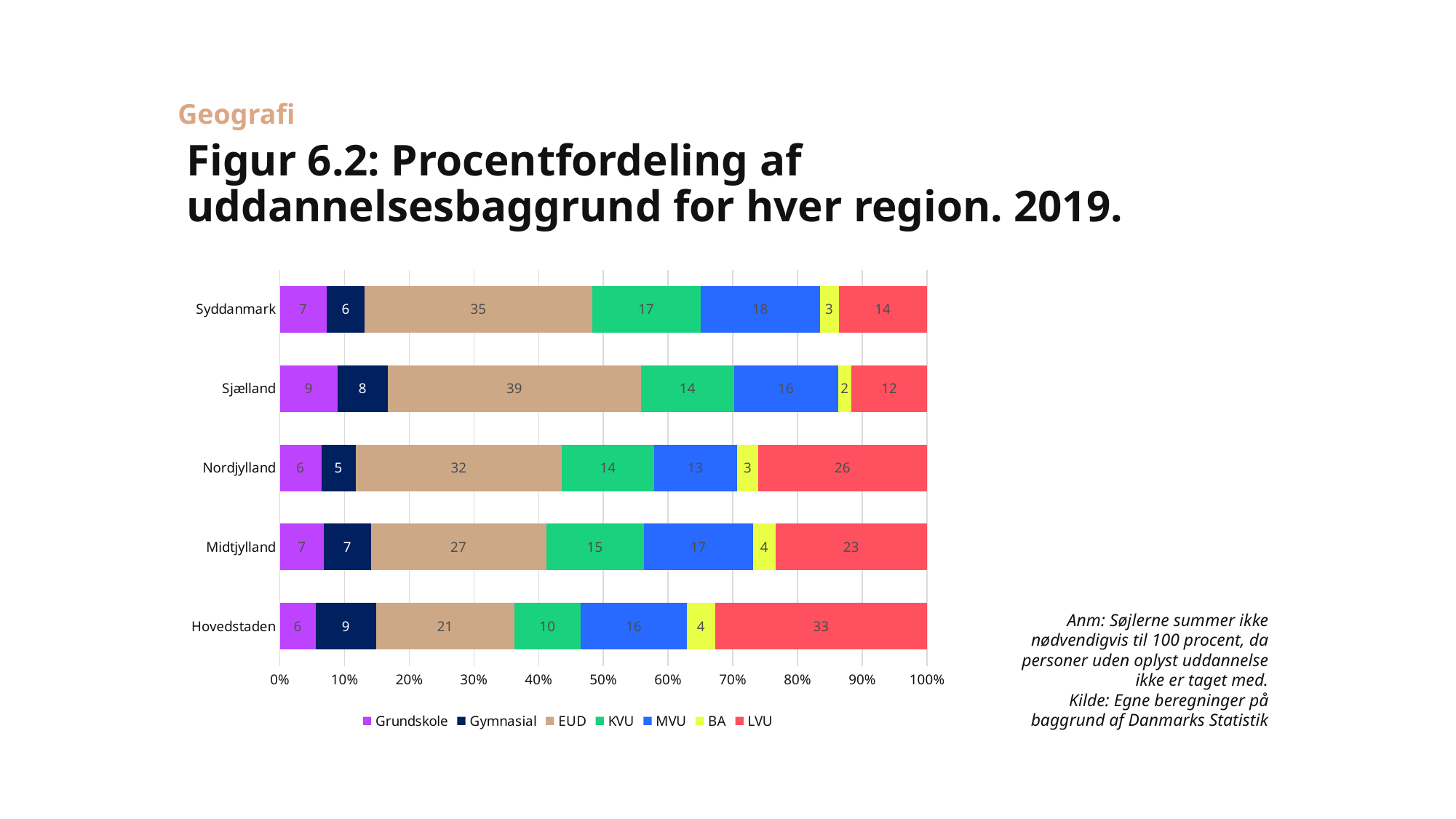
Which region has the lowest EUD value? Hovedstaden What is the Gymnasial value for Hovedstaden? 9 Which colour represents the BA series in the legend? Yellow How many series does the legend list? 7 Which is larger, the KVU value for Syddanmark or the KVU value for Hovedstaden? Syddanmark What kind of chart is shown on the slide? Stacked bar chart Which region has the highest LVU value? Hovedstaden What is the difference between the LVU values for Nordjylland and Syddanmark? 12 What is the EUD value for Sjælland? 39 How many regions are shown on the chart? 5 What is the LVU value for Hovedstaden? 33 What is the MVU value for Nordjylland? 13